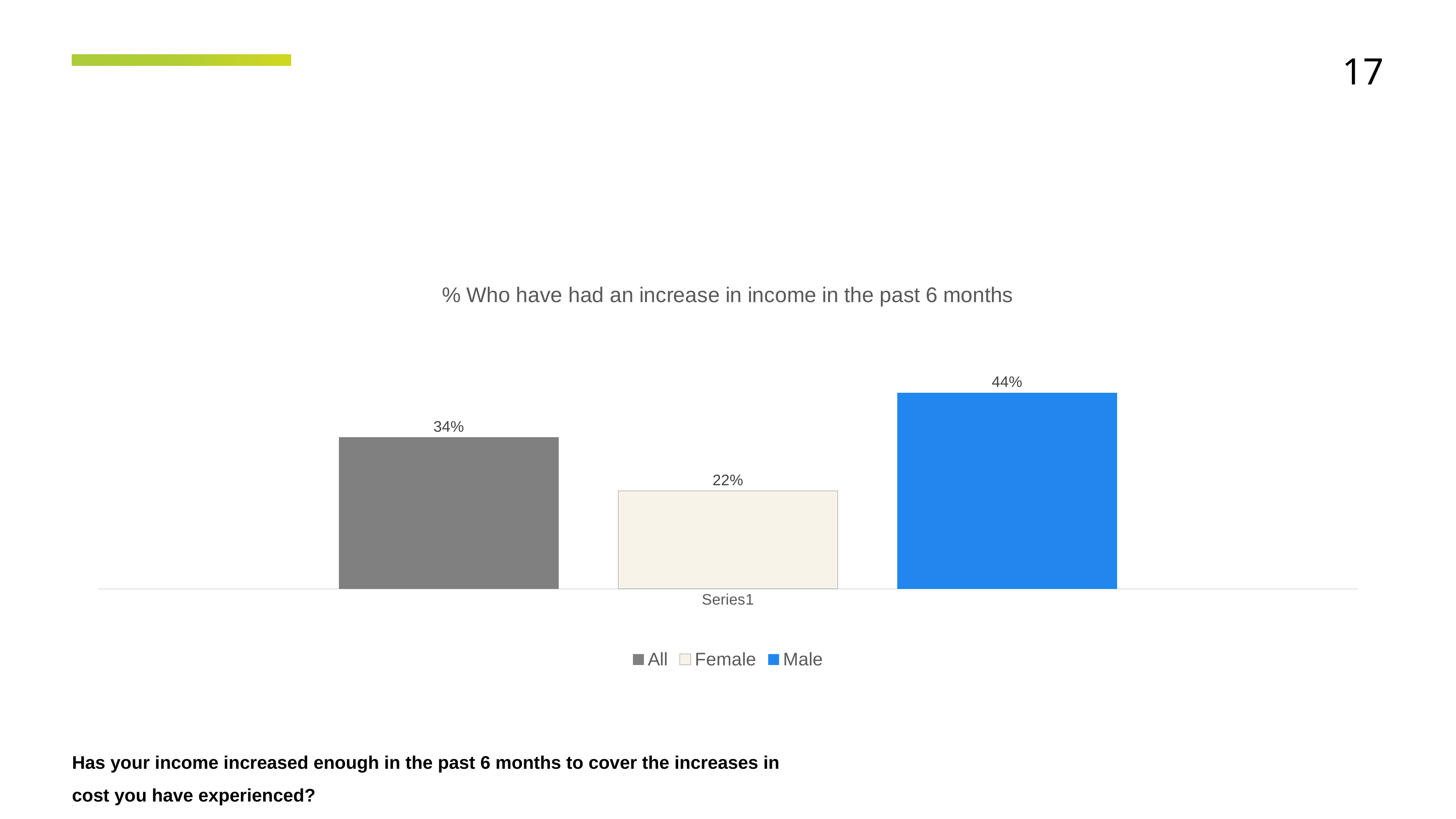
What is the value for All in the chart? 34% What is the value for Male in the chart? 44% What is the title of the chart? % Who have had an increase in income in the past 6 months Which series has the lowest value? Female What colour is the Male bar? Blue What is the difference between the Male and Female values? 22% What kind of chart is shown on the slide? Bar chart Which is larger, the value for All or the value for Female? All Which series has the highest value? Male How many series does the legend list? 3 What is the difference between the Male and All values? 10% What is the value for Female in the chart? 22%